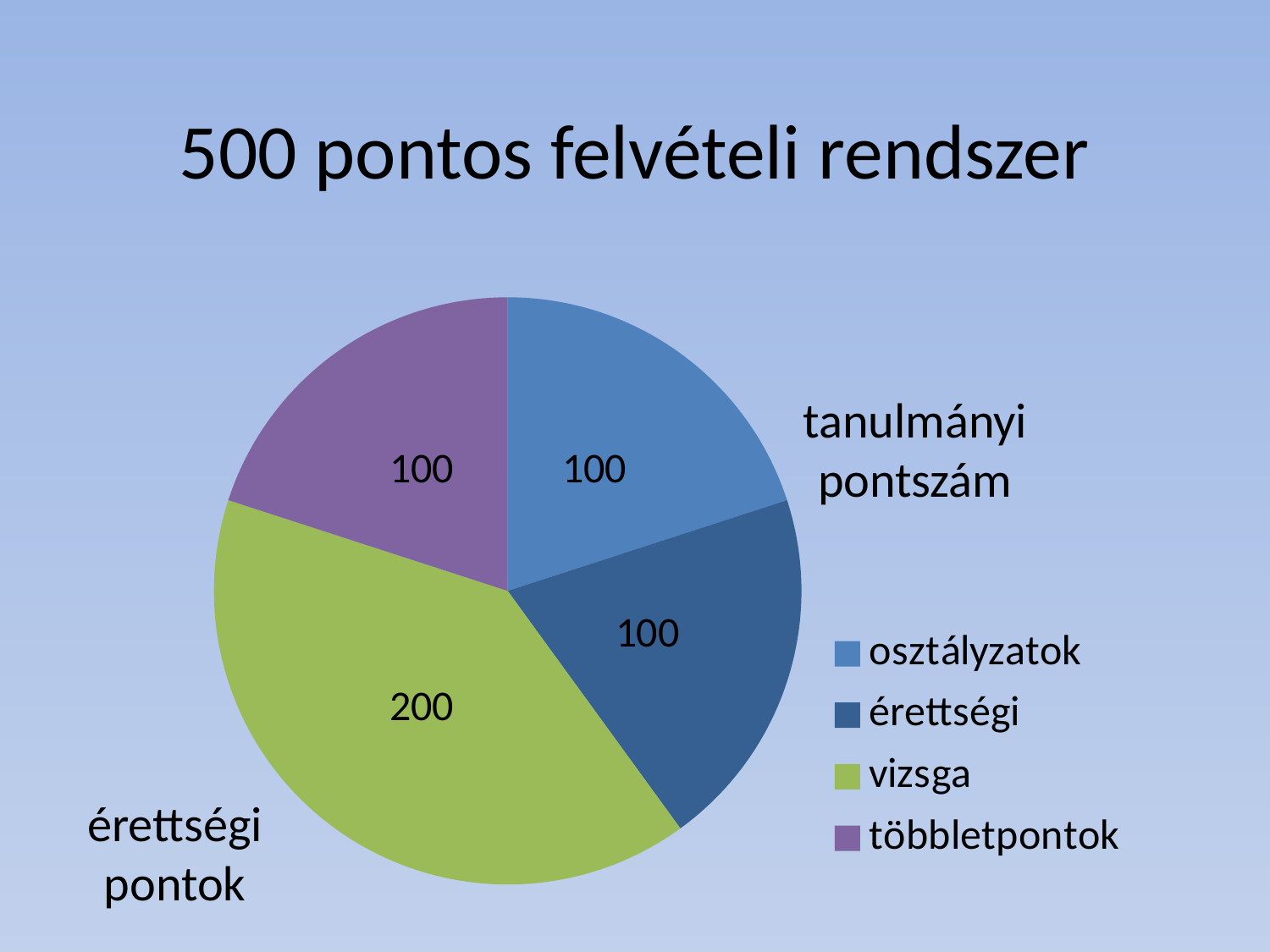
How many slices does the pie chart have? 4 What is the value of the többletpontok slice? 100 What kind of chart is shown on the slide? pie chart What share of the pie does the vizsga slice represent? 40% What is the title of the slide? 500 pontos felvételi rendszer Which category has the largest slice of the pie? vizsga What is the value of the osztályzatok slice? 100 What is the difference between the vizsga value and the érettségi value? 100 How many entries does the legend list? 4 What share of the pie does the többletpontok slice represent? 20% Which is larger, the vizsga slice or the osztályzatok slice? vizsga What is the value of the vizsga slice? 200